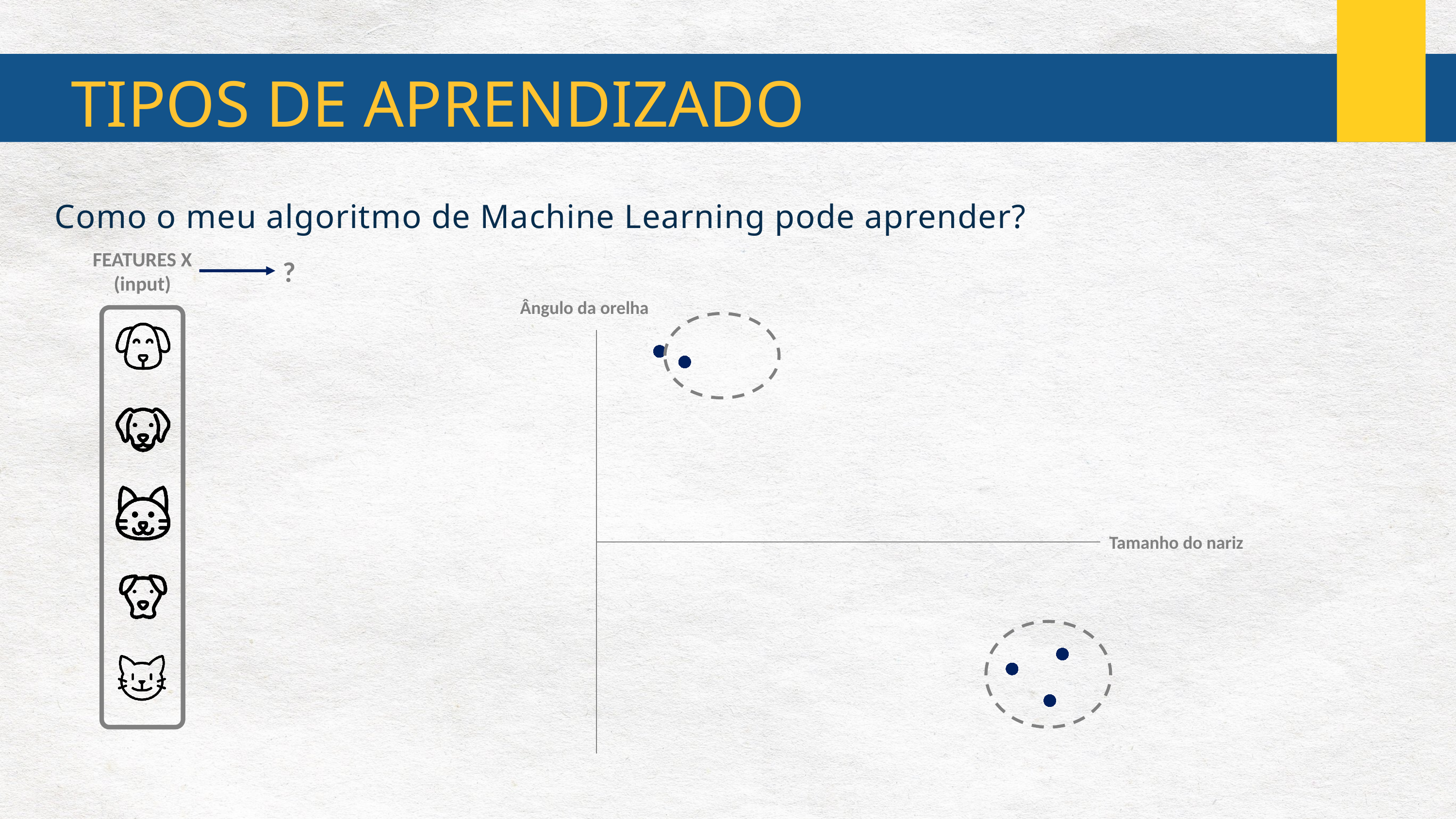
How many points are inside the upper-left dashed cluster? 2 How many dashed circled groups (clusters) are drawn on the chart? 2 What is the label of the horizontal axis of the chart? Tamanho do nariz What is the label of the vertical axis of the chart? Ângulo da orelha How many data points are plotted on the chart? 5 Which cluster has the larger values of Ângulo da orelha: the cluster with 2 points or the cluster with 3 points? the cluster with 2 points What kind of chart is shown on the slide? scatter plot Does the chart have a legend listing any series? No Which cluster has the larger values of Tamanho do nariz: the cluster with 2 points or the cluster with 3 points? the cluster with 3 points